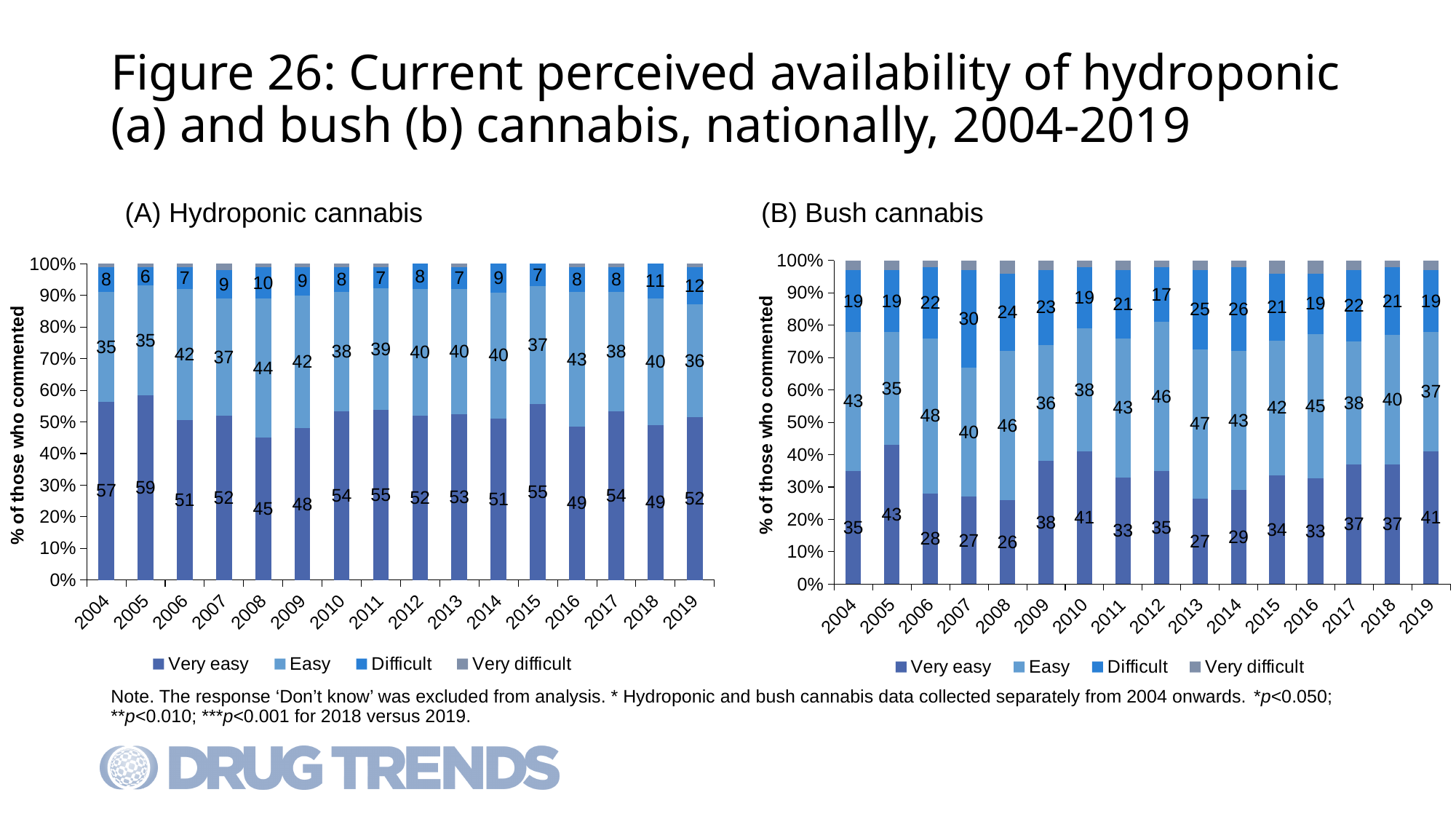
What kind of chart is the (B) Bush cannabis chart? Stacked bar chart In the (A) Hydroponic cannabis chart, what percentage of respondents said 'Very easy' in 2008? 45 In the (B) Bush cannabis chart, which is larger: the 'Very easy' value for 2010 or for 2011? 2010 How many years are shown on the x axis of the (A) Hydroponic cannabis chart? 16 In the (A) Hydroponic cannabis chart, which is larger: the 'Easy' value for 2008 or for 2019? 2008 In the (A) Hydroponic cannabis chart, what is the difference between the 'Difficult' values for 2019 and 2018? 1 What is the y-axis label of the (A) Hydroponic cannabis chart? % of those who commented How many series does the legend of the (B) Bush cannabis chart list? 4 In the (B) Bush cannabis chart, what is the difference between the 'Easy' values for 2006 and 2005? 13 In the (B) Bush cannabis chart, which year has the lowest 'Very easy' value? 2008 In the (B) Bush cannabis chart, what is the 'Difficult' value for 2007? 30 In the (A) Hydroponic cannabis chart, which year has the highest 'Very easy' value? 2005